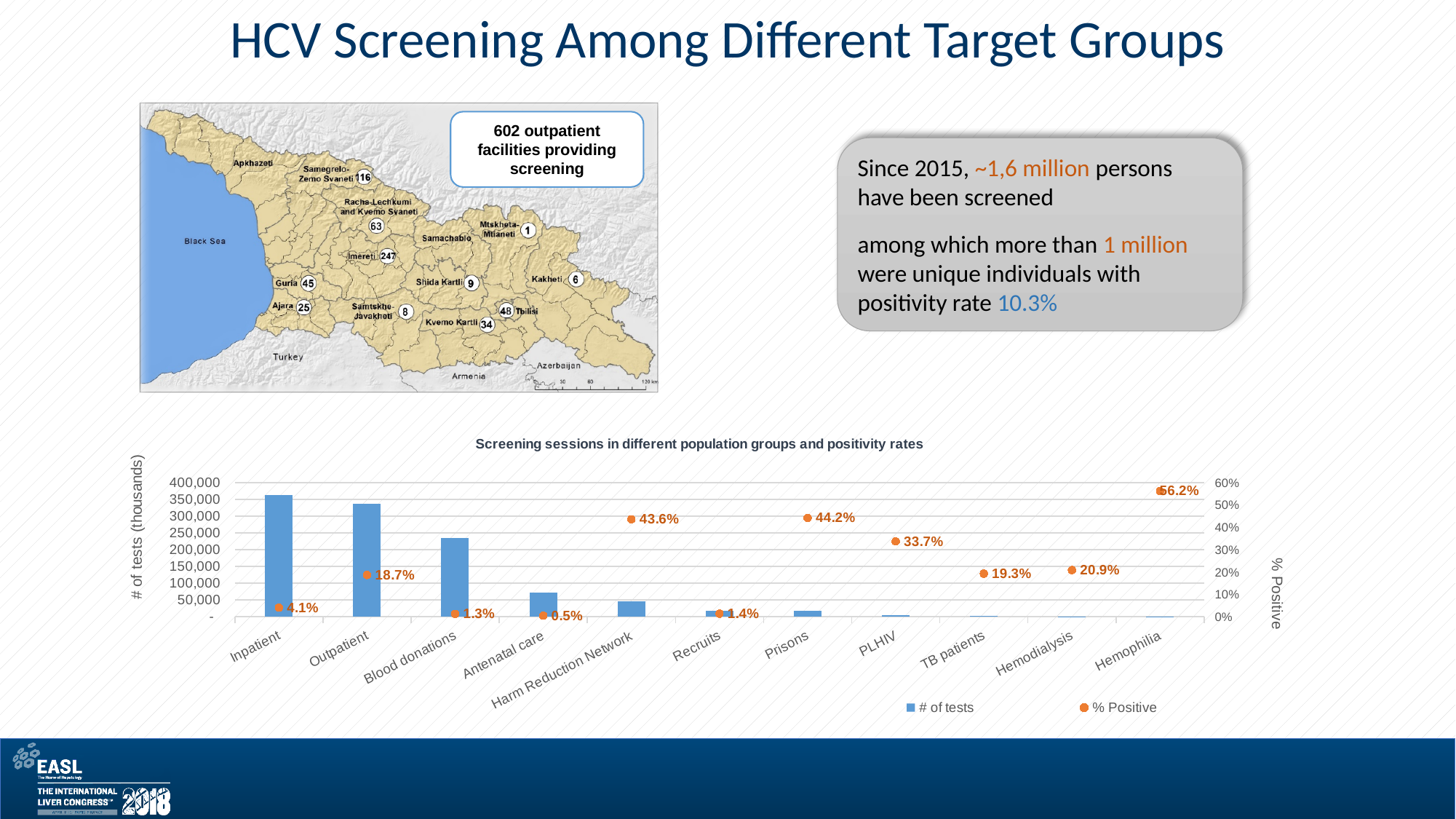
Which population group has the lowest % Positive? Antenatal care Is the number of tests for Inpatient greater or less than 300,000? greater What is the % Positive value for Harm Reduction Network in the chart 'Screening sessions in different population groups and positivity rates'? 43.6% Which population group has the highest % Positive? Hemophilia Is the number of tests for Antenatal care greater or less than 100,000? less Which population group has the most tests (tallest bar)? Inpatient What is the difference in % Positive between Prisons and Harm Reduction Network? 0.6% What is the % Positive value for PLHIV? 33.7% Which has a higher % Positive, Hemodialysis or TB patients? Hemodialysis What is the % Positive value for Outpatient? 18.7% How many population groups are shown on the x axis of the chart? 11 How many series does the chart legend list? 2